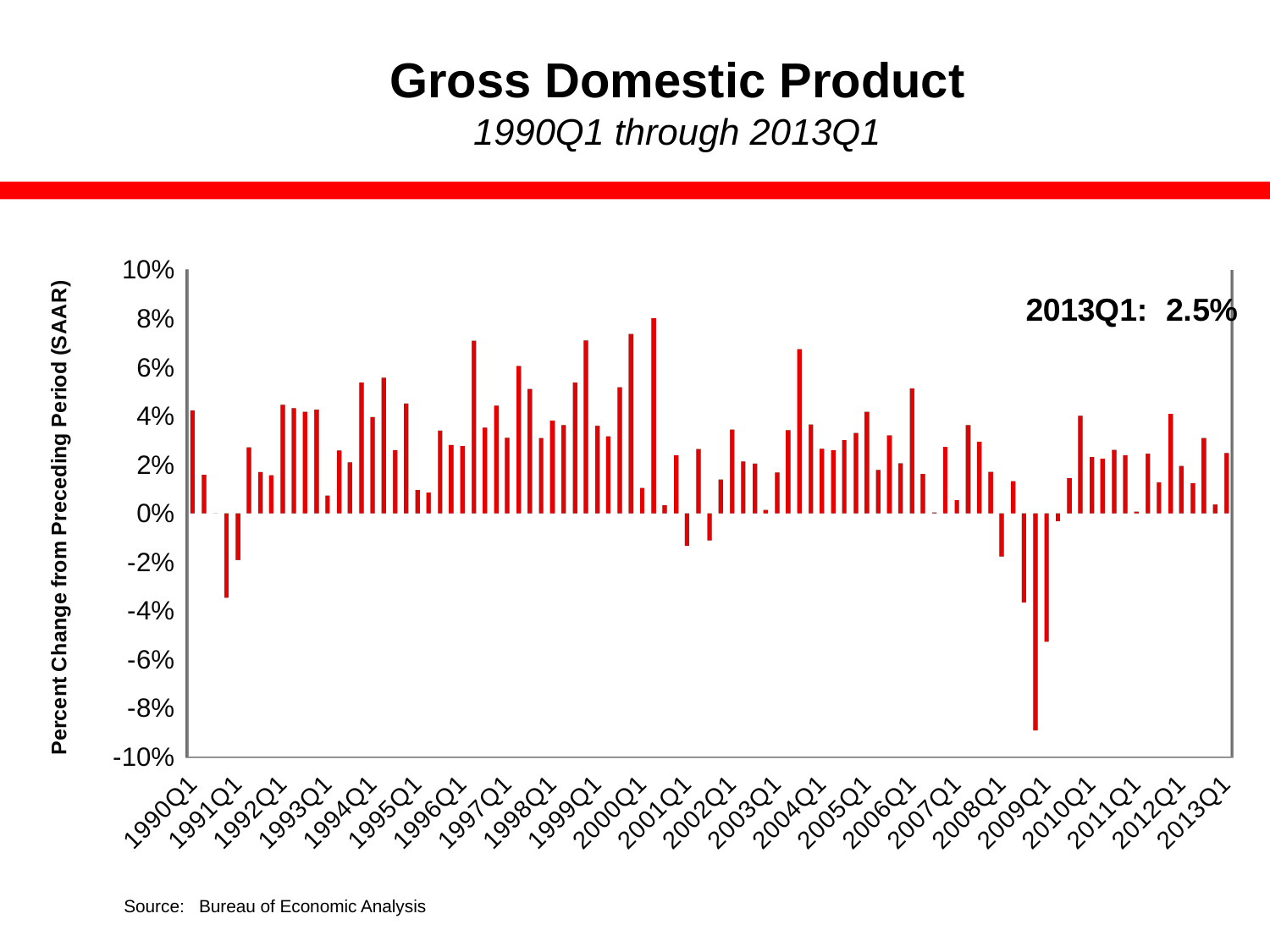
Which is larger, the value for 1990Q1 or the value for 1991Q1? 1990Q1 Is the highest bar on the chart greater or less than 6%? greater How many year labels are shown on the x axis? 24 Which is larger, the value for 2009Q1 or the value for 2010Q1? 2010Q1 Is the value for 2009Q1 greater or less than -4%? less Between 2008Q1 and 2009Q1, do the values generally rise or fall? fall What kind of chart is shown on the slide? bar chart Is the lowest bar on the chart greater or less than -8%? less What is the value printed for 2013Q1? 2.5% What is the title of the y axis? Percent Change from Preceding Period (SAAR)